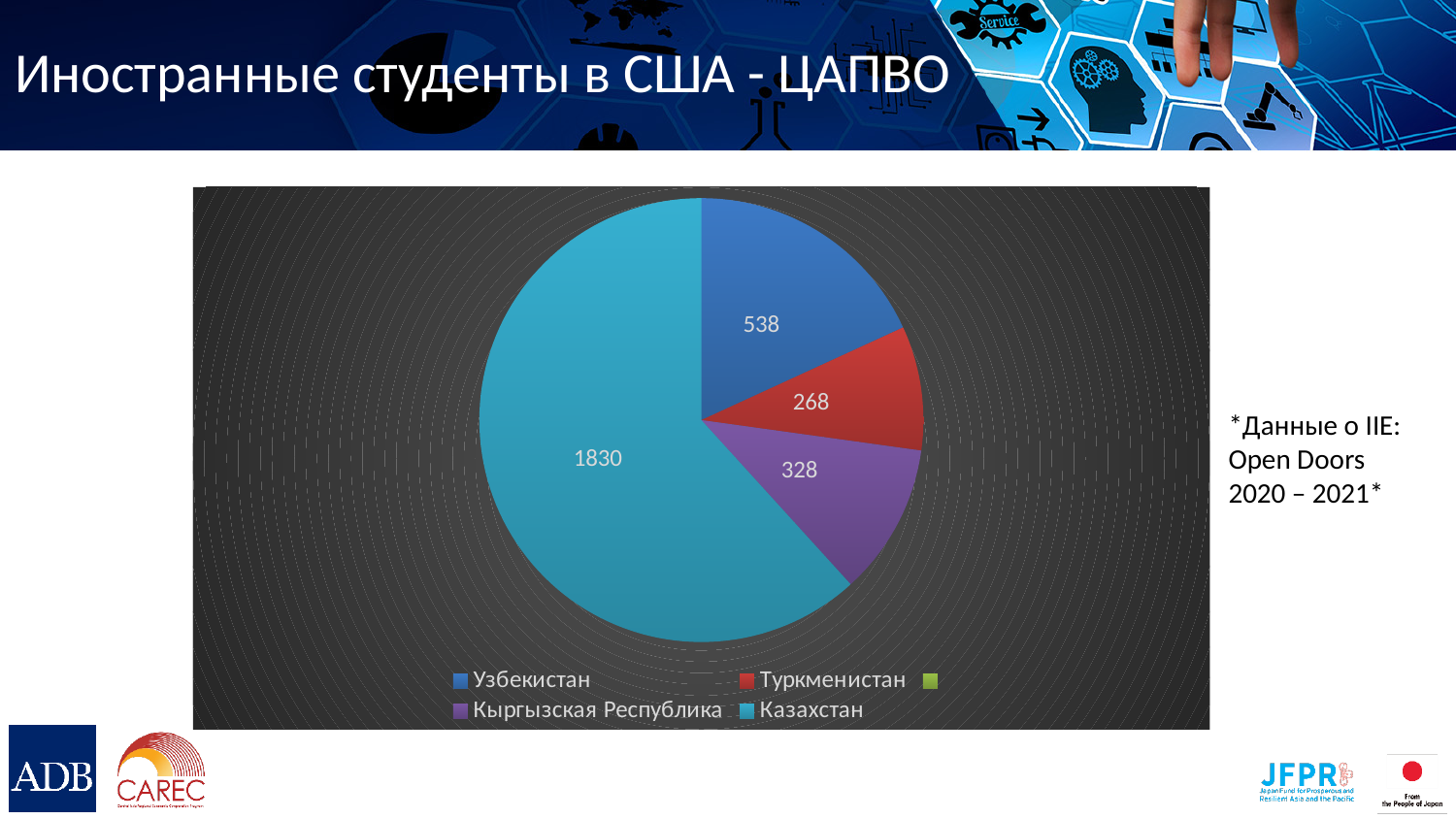
What is the value for Кыргызская Республика? 328 What is the value for Казахстан? 1830 What is the difference between the values for Кыргызская Республика and Туркменистан? 60 What colour is the slice for Казахстан? cyan (light blue) What is the difference between the values for Казахстан and Узбекистан? 1292 What is the value for Туркменистан? 268 Which is larger, the value for Узбекистан or the value for Кыргызская Республика? Узбекистан What is the total of all the values shown in the pie chart? 2964 Which country has the smallest slice of the pie? Туркменистан Which country has the largest slice of the pie? Казахстан What type of chart is shown on the slide? pie chart What is the value for Узбекистан? 538